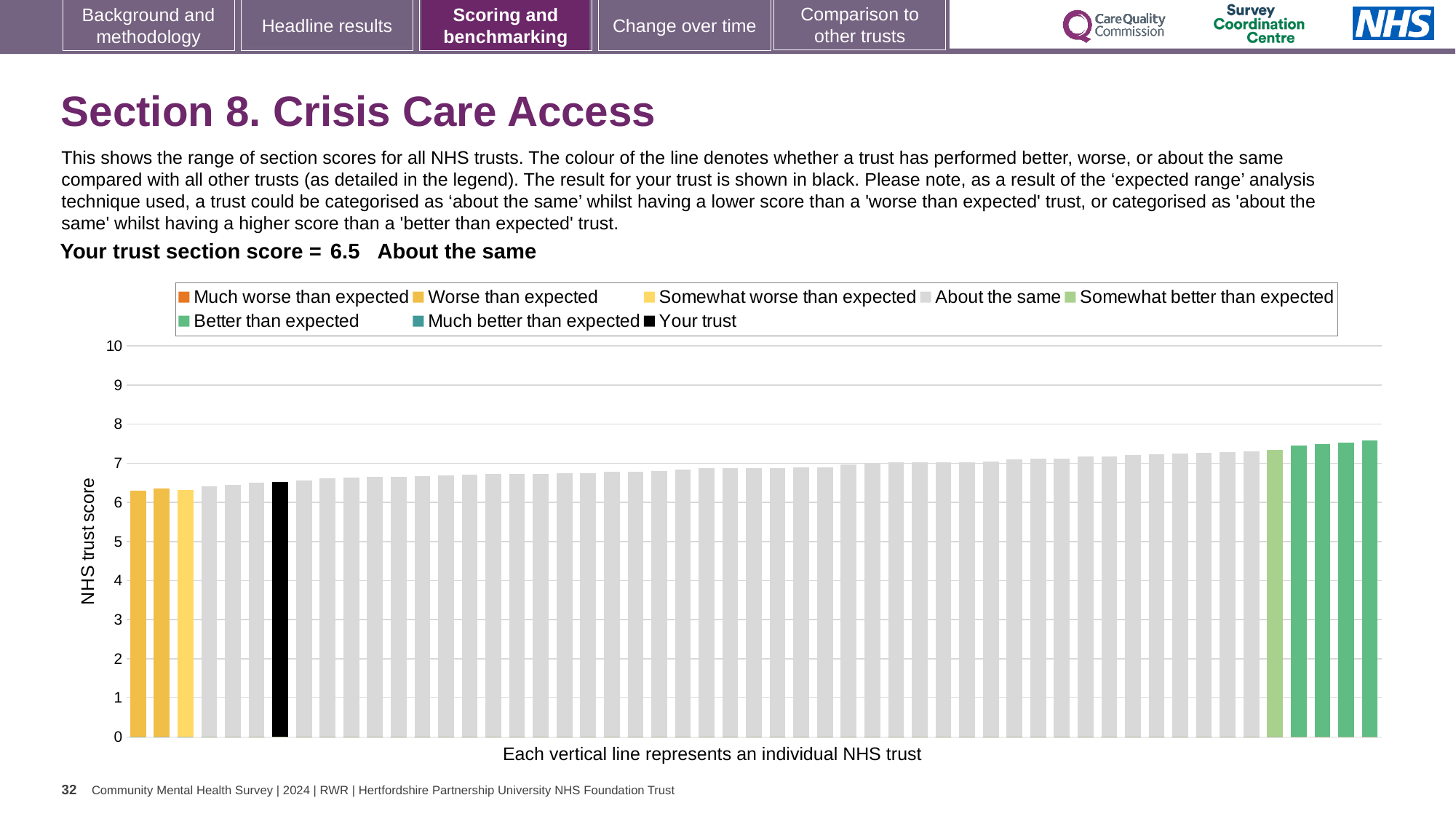
Is the value of the black 'Your trust' bar greater or less than 6? greater Is the value of the leftmost (lowest) bar greater or less than 6? greater Is the value of the black 'Your trust' bar greater or less than 7? less Do the bar values rise or fall from left to right along the x axis? rise What is the label on the y axis of the chart? NHS trust score How many bars are coloured as 'Better than expected'? 4 What is the section score for your trust? 6.5 How many entries does the chart legend list? 8 What kind of chart is shown on the slide? bar chart Which category is your trust's section score placed in? About the same How many bars are coloured as 'Worse than expected'? 2